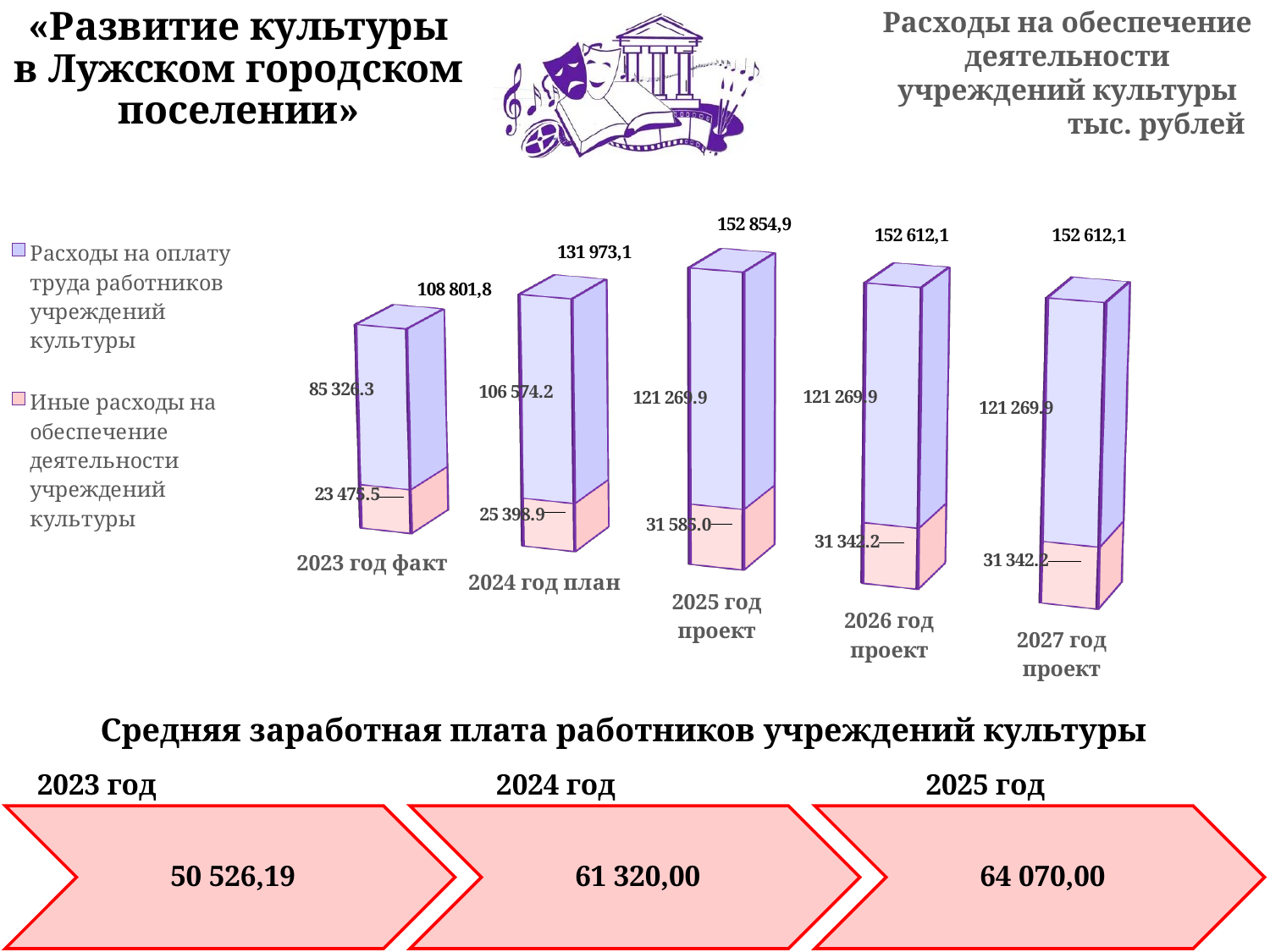
What kind of chart is shown on the slide? stacked bar chart Which is larger: Иные расходы for 2026 год проект or Иные расходы for 2025 год проект? 2025 год проект What is the total value printed above the bar for 2027 год проект? 152 612,1 What is the total value printed above the bar for 2023 год факт? 108 801,8 What is the difference between the total for 2024 год план and the total for 2023 год факт? 23 171,3 What is the value of Расходы на оплату труда работников учреждений культуры for 2024 год план? 106 574.2 How many series does the chart legend list? 2 What is the value of Иные расходы на обеспечение деятельности учреждений культуры for 2025 год проект? 31 585.0 Does the total expenditure rise or fall from 2023 год факт to 2025 год проект? rise How many year categories are shown on the x axis of the chart? 5 Which year has the lowest total expenditure in the chart? 2023 год факт Which year has the highest total expenditure in the chart? 2025 год проект